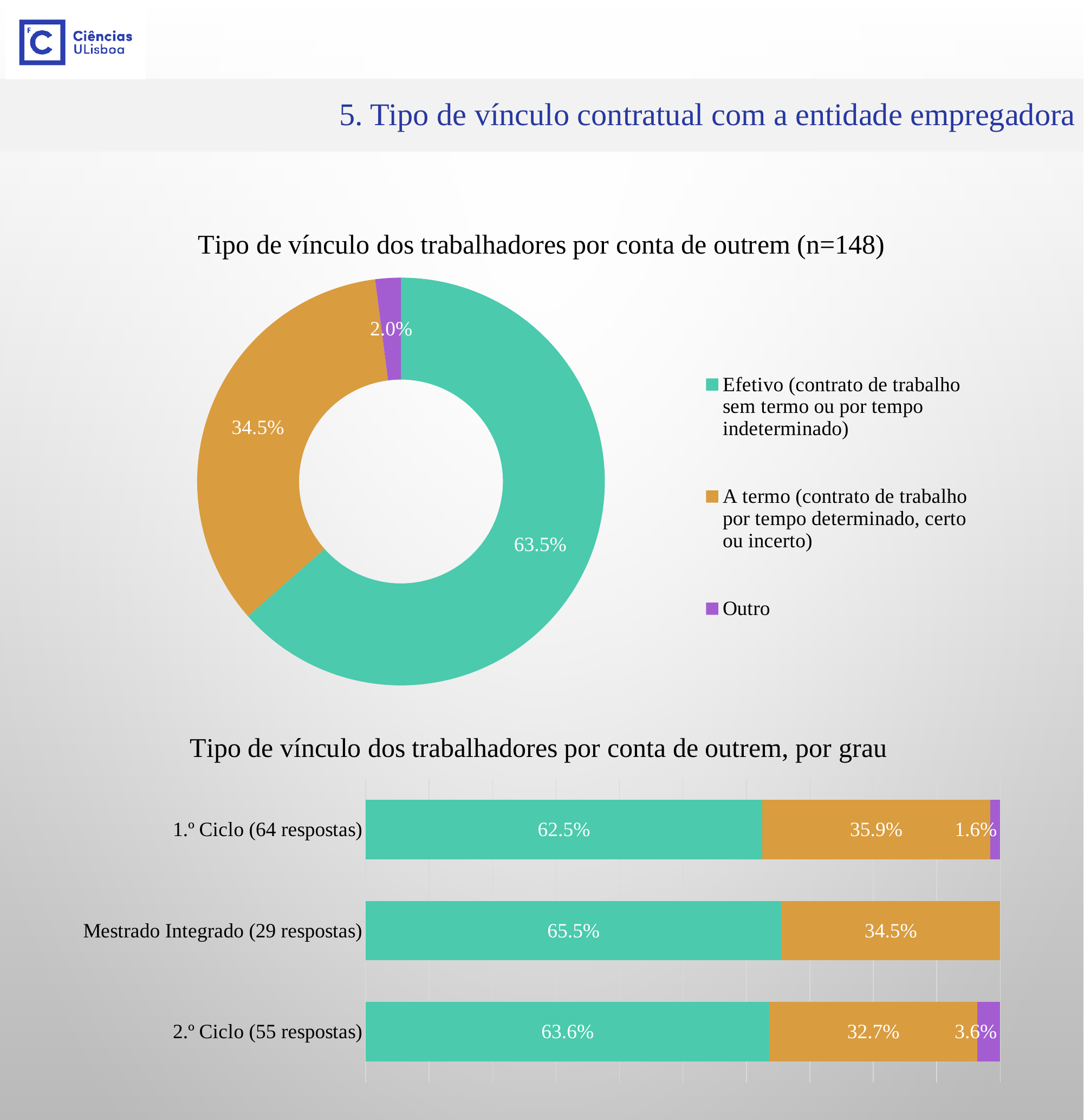
In the chart titled 'Tipo de vínculo dos trabalhadores por conta de outrem, por grau', what is the difference between the 'Efetivo' values for 'Mestrado Integrado (29 respostas)' and '1.º Ciclo (64 respostas)'? 3.0% In the chart titled 'Tipo de vínculo dos trabalhadores por conta de outrem (n=148)', which category has the smallest slice? Outro In the chart titled 'Tipo de vínculo dos trabalhadores por conta de outrem, por grau', which category has the highest 'Efetivo' value? Mestrado Integrado (29 respostas) In the chart titled 'Tipo de vínculo dos trabalhadores por conta de outrem (n=148)', what share of the pie is 'Outro'? 2.0% In the chart titled 'Tipo de vínculo dos trabalhadores por conta de outrem, por grau', what is the 'Outro' value for '2.º Ciclo (55 respostas)'? 3.6% In the chart titled 'Tipo de vínculo dos trabalhadores por conta de outrem (n=148)', which category has the largest slice? Efetivo (contrato de trabalho sem termo ou por tempo indeterminado) In the chart titled 'Tipo de vínculo dos trabalhadores por conta de outrem, por grau', what is the 'Efetivo' value for '1.º Ciclo (64 respostas)'? 62.5% What kind of chart is the chart titled 'Tipo de vínculo dos trabalhadores por conta de outrem (n=148)'? Pie chart (doughnut) In the chart titled 'Tipo de vínculo dos trabalhadores por conta de outrem (n=148)', what share of the pie is 'A termo (contrato de trabalho por tempo determinado, certo ou incerto)'? 34.5% In the chart titled 'Tipo de vínculo dos trabalhadores por conta de outrem (n=148)', what share of the pie is 'Efetivo (contrato de trabalho sem termo ou por tempo indeterminado)'? 63.5% How many entries does the legend of the chart titled 'Tipo de vínculo dos trabalhadores por conta de outrem (n=148)' list? 3 In the chart titled 'Tipo de vínculo dos trabalhadores por conta de outrem, por grau', what is the 'A termo' value for '2.º Ciclo (55 respostas)'? 32.7%